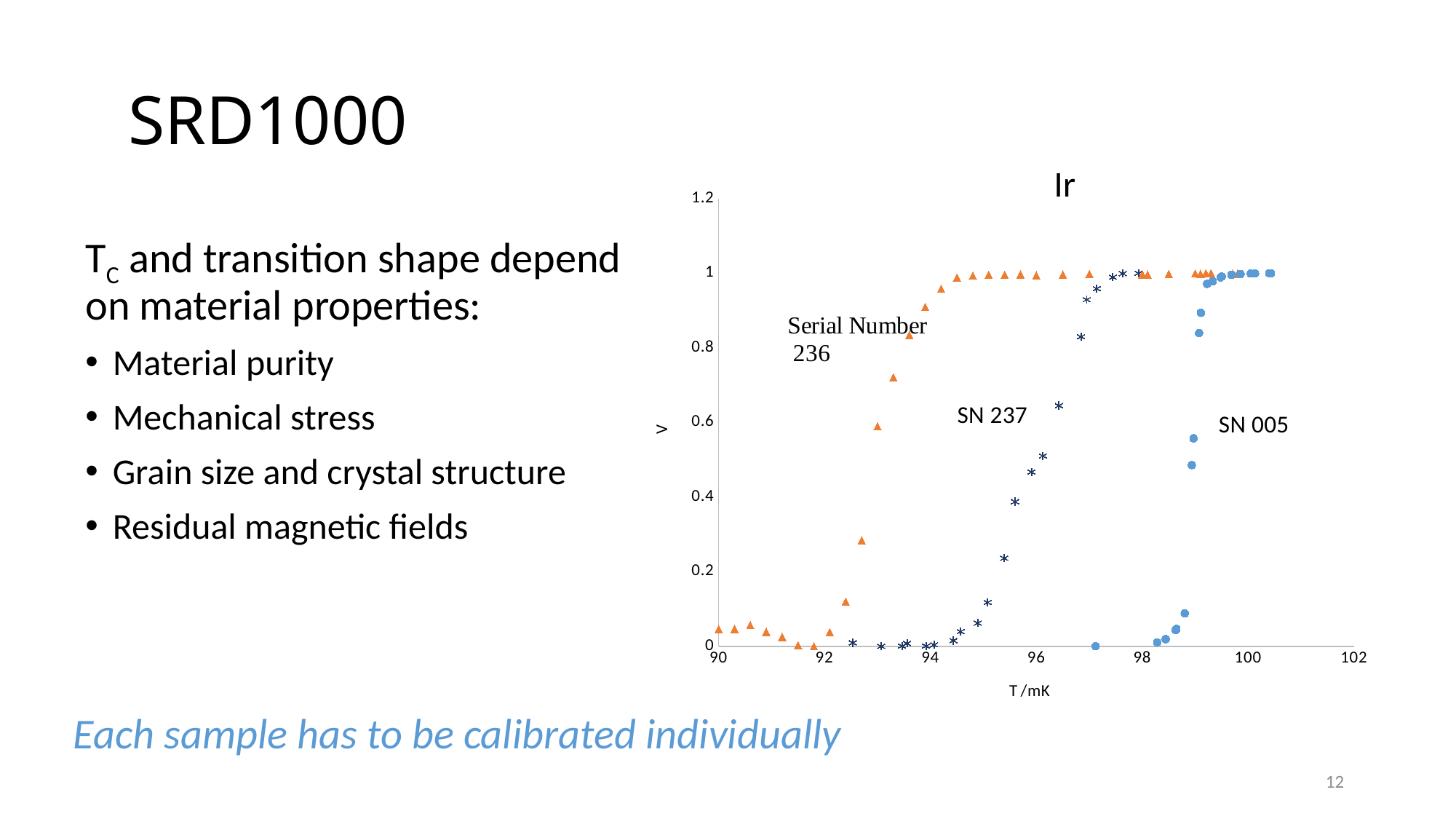
What is the label of the x axis of the chart? T /mK What kind of chart is shown on the slide? scatter chart Which series reaches a value of 1 at the highest temperature? SN 005 How many data series are plotted on the chart? 3 Is the value for SN 005 at T = 97 mK greater or less than 0.2? less Is the value for SN 005 at T = 100 mK greater or less than 0.8? greater Is the value for Serial Number 236 at T = 93 mK greater or less than 0.4? greater Which series reaches a value of 1 at the lowest temperature? Serial Number 236 What is the title of the chart? Ir Do the values for SN 237 rise or fall as T increases along the x axis? rise